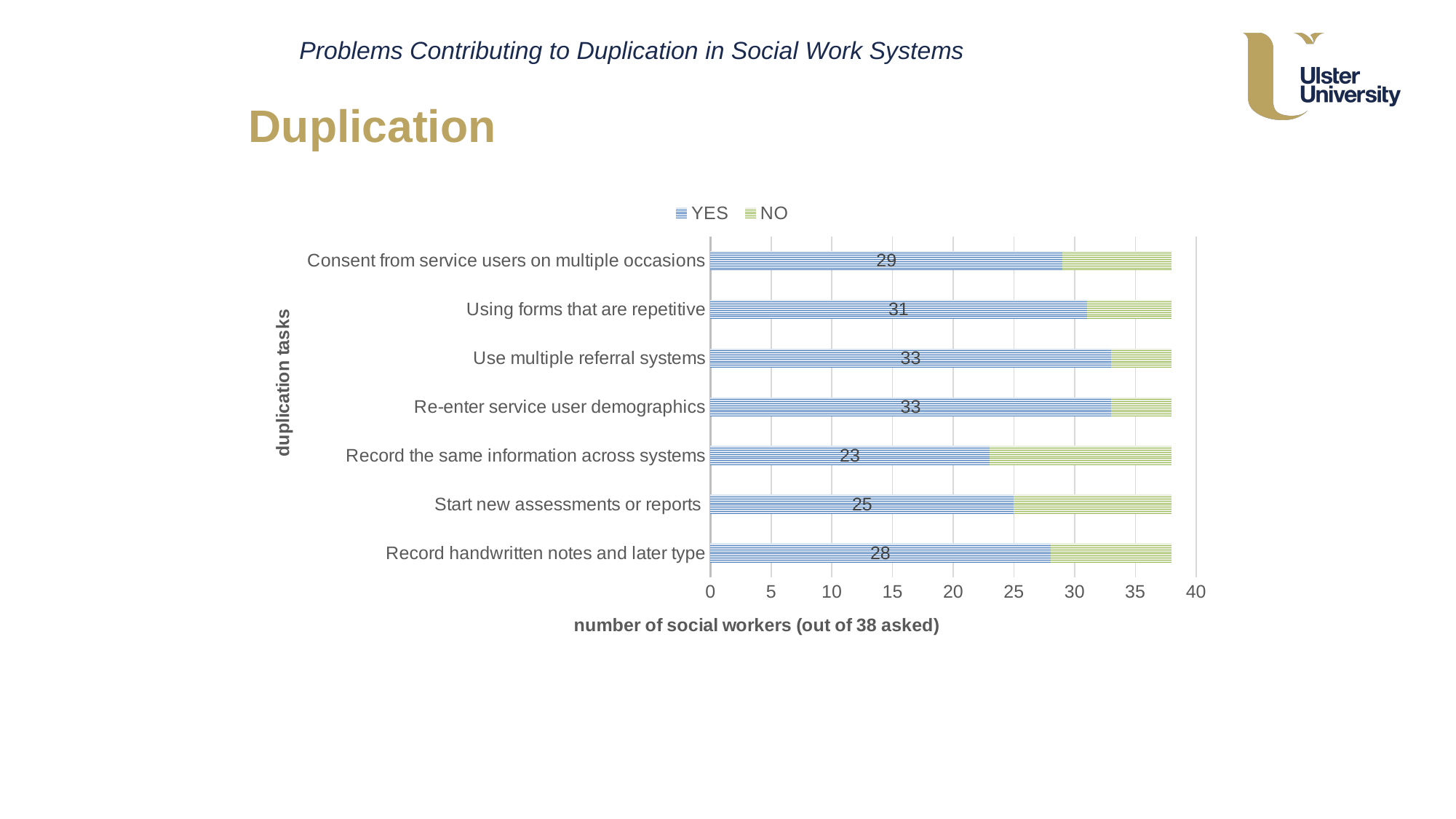
How many duplication tasks are listed on the chart? 7 What is the difference between the YES values for 'Use multiple referral systems' and 'Record the same information across systems'? 10 What is the title of the horizontal axis? number of social workers (out of 38 asked) Which duplication task has the lowest YES value? Record the same information across systems What kind of chart is shown on the slide? Stacked bar chart How many series does the legend list? 2 What is the YES value for 'Consent from service users on multiple occasions'? 29 What is the YES value for 'Record the same information across systems'? 23 What is the difference between the YES values for 'Using forms that are repetitive' and 'Consent from service users on multiple occasions'? 2 Which has a larger YES value: 'Start new assessments or reports' or 'Record handwritten notes and later type'? Record handwritten notes and later type What is the YES value for 'Record handwritten notes and later type'? 28 How many social workers answered YES for 'Using forms that are repetitive'? 31